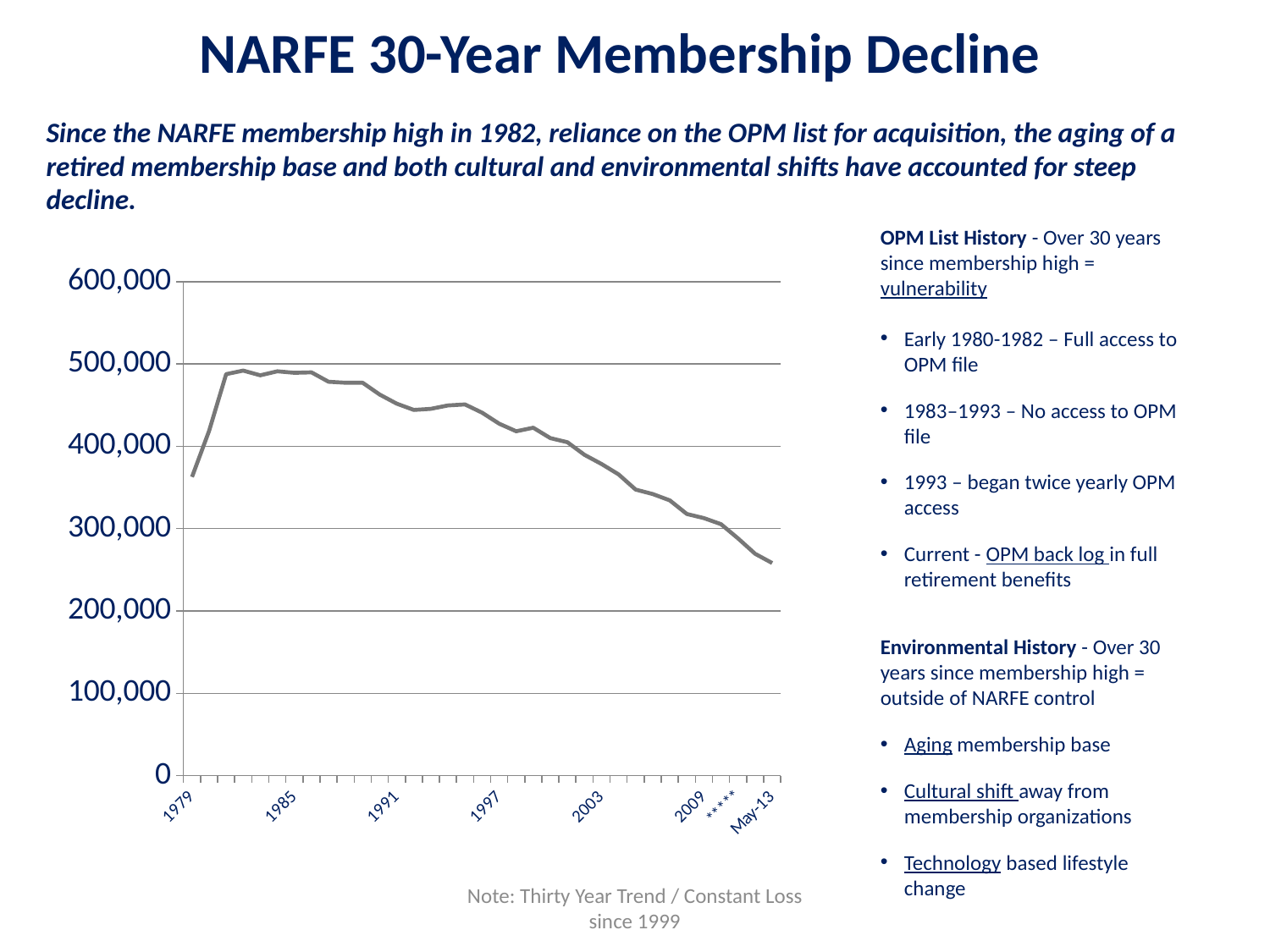
What is the title of the slide containing the chart? NARFE 30-Year Membership Decline What is the highest value shown on the chart's vertical axis? 600,000 Is the value for 1979 greater or less than 400,000? less What kind of chart is shown on the slide? line chart Which is larger, the value for 1979 or the value for May-13? 1979 Is the value for 1997 greater or less than 400,000? greater Overall, do the membership values rise or fall along the x axis from 1985 to May-13? fall Is the value for 1985 greater or less than 400,000? greater Which is larger, the value for 1985 or the value for 2003? 1985